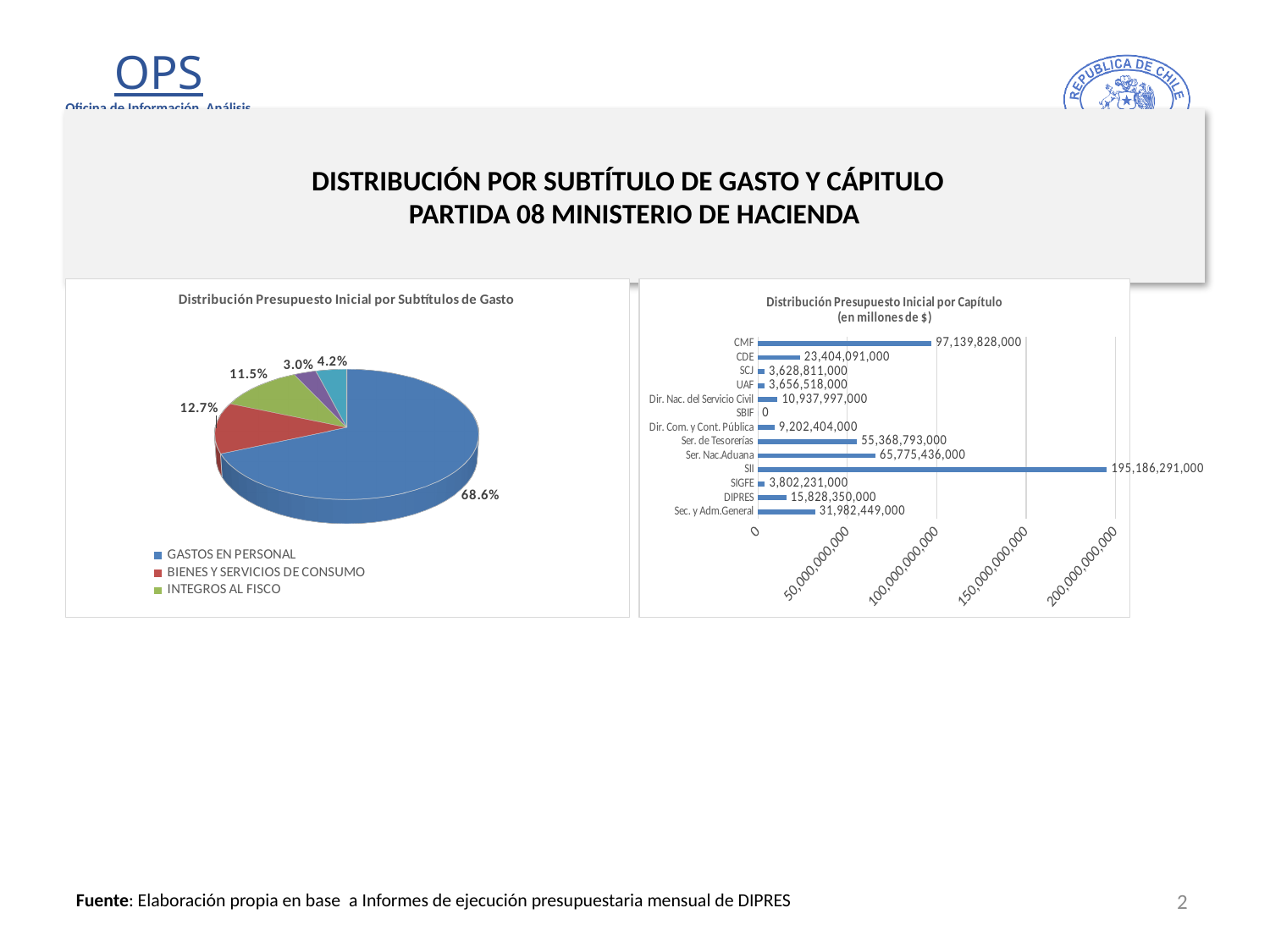
In the 'Distribución Presupuesto Inicial por Capítulo' chart, what is the value for CMF? 97,139,828,000 In the 'Distribución Presupuesto Inicial por Capítulo' chart, which capítulo has the highest value? SII In the 'Distribución Presupuesto Inicial por Capítulo' chart, what is the value for SII? 195,186,291,000 In the 'Distribución Presupuesto Inicial por Subtítulos de Gasto' pie chart, what share does BIENES Y SERVICIOS DE CONSUMO have? 12.7% What kind of chart is 'Distribución Presupuesto Inicial por Subtítulos de Gasto'? Pie chart In the 'Distribución Presupuesto Inicial por Capítulo' chart, what is the difference between the values for Ser. Nac.Aduana and Ser. de Tesorerías? 10,406,643,000 In the 'Distribución Presupuesto Inicial por Subtítulos de Gasto' pie chart, what share does GASTOS EN PERSONAL have? 68.6% In the 'Distribución Presupuesto Inicial por Capítulo' chart, what is the value for DIPRES? 15,828,350,000 What kind of chart is 'Distribución Presupuesto Inicial por Capítulo'? Bar chart In the 'Distribución Presupuesto Inicial por Capítulo' chart, which capítulo has the lowest value? SBIF In the 'Distribución Presupuesto Inicial por Capítulo' chart, which is larger, the value for CDE or the value for Sec. y Adm.General? Sec. y Adm.General In the 'Distribución Presupuesto Inicial por Capítulo' chart, how many capítulos are shown? 13